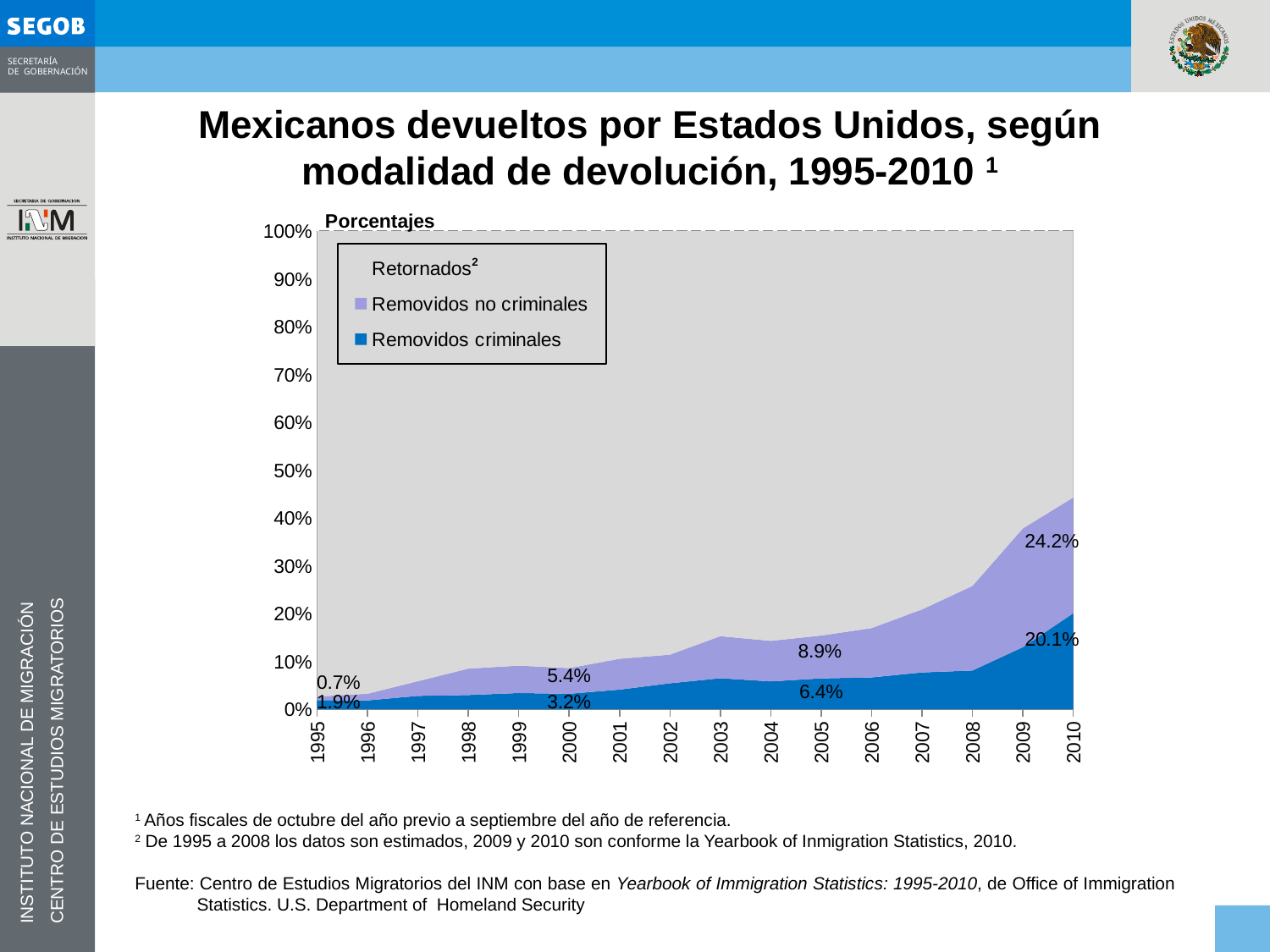
What is the value for Removidos no criminales in 2010? 24.2% What kind of chart is shown on the slide? Stacked area chart What is the difference between Removidos no criminales and Removidos criminales in 2010? 4.1 percentage points What is the value for Removidos no criminales in 2000? 5.4% How many series does the legend list? 3 What is the value for Removidos criminales in 1995? 1.9% What is the value for Removidos criminales in 2010? 20.1% Which is larger in 2005, Removidos no criminales or Removidos criminales? Removidos no criminales Does the share of Removidos criminales rise or fall from 1995 to 2010? Rise Is the value for Removidos criminales in 2008 greater or less than 10%? less How many years are shown along the x axis? 16 What is the value for Removidos criminales in 2005? 6.4%